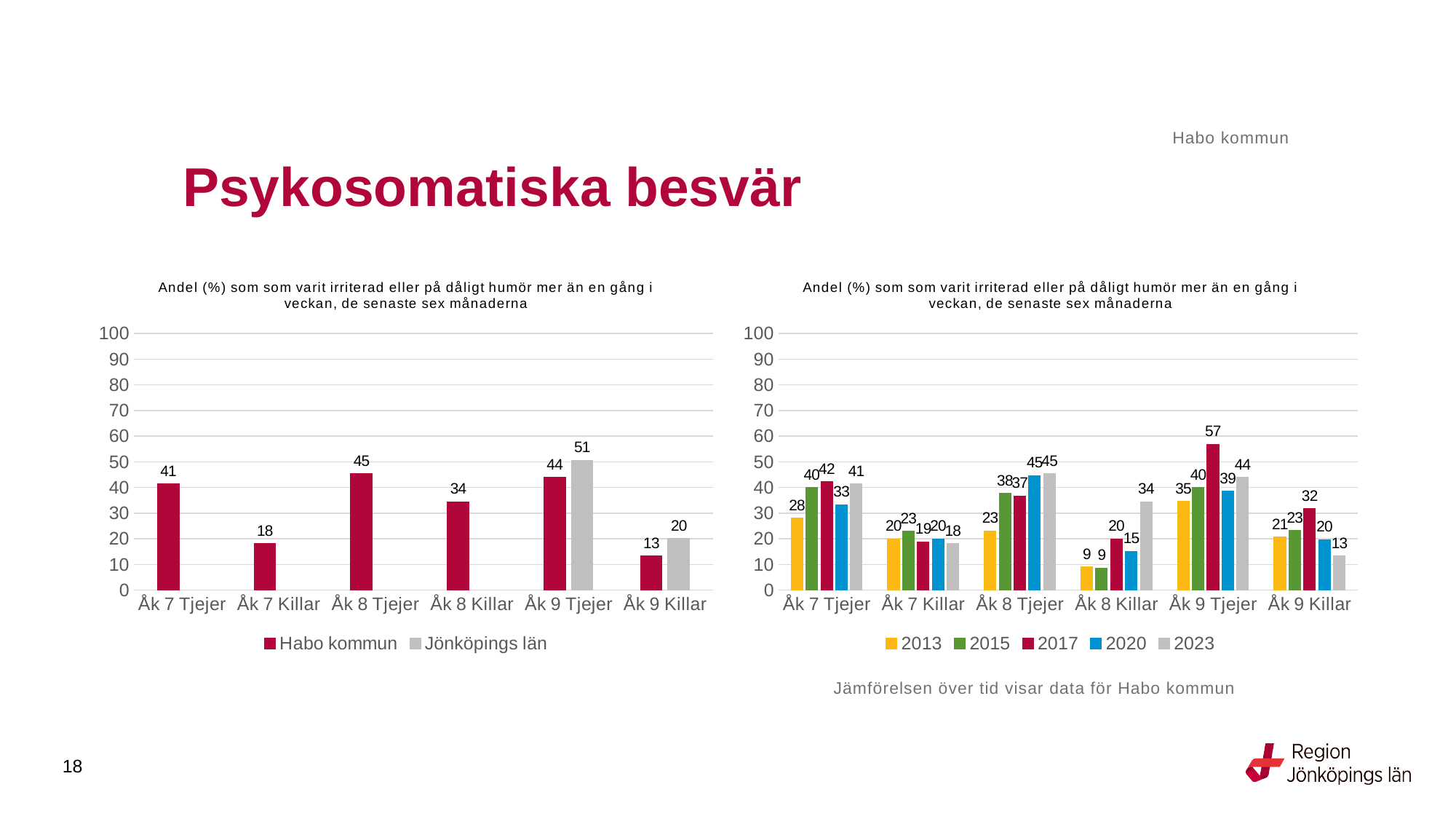
In the right chart, which year has the highest value for Åk 9 Killar? 2017 In the right chart, is the 2020 value for Åk 7 Tjejer larger or smaller than the 2023 value? smaller In the left chart, how many series does the legend list? 2 In the right chart, what is the difference between the 2023 and 2013 values for Åk 8 Killar? 25 In the right chart, what is the value for 2013 for Åk 8 Killar? 9 In the left chart, what is the difference between Jönköpings län and Habo kommun for Åk 9 Killar? 7 What kind of chart is the right chart? bar chart In the left chart, which category has the lowest value for Habo kommun? Åk 9 Killar In the right chart, what is the value for 2017 for Åk 9 Tjejer? 57 In the left chart, what is the value for Jönköpings län for Åk 9 Tjejer? 51 In the left chart, what is the value for Habo kommun for Åk 8 Tjejer? 45 In the right chart, how many series does the legend list? 5